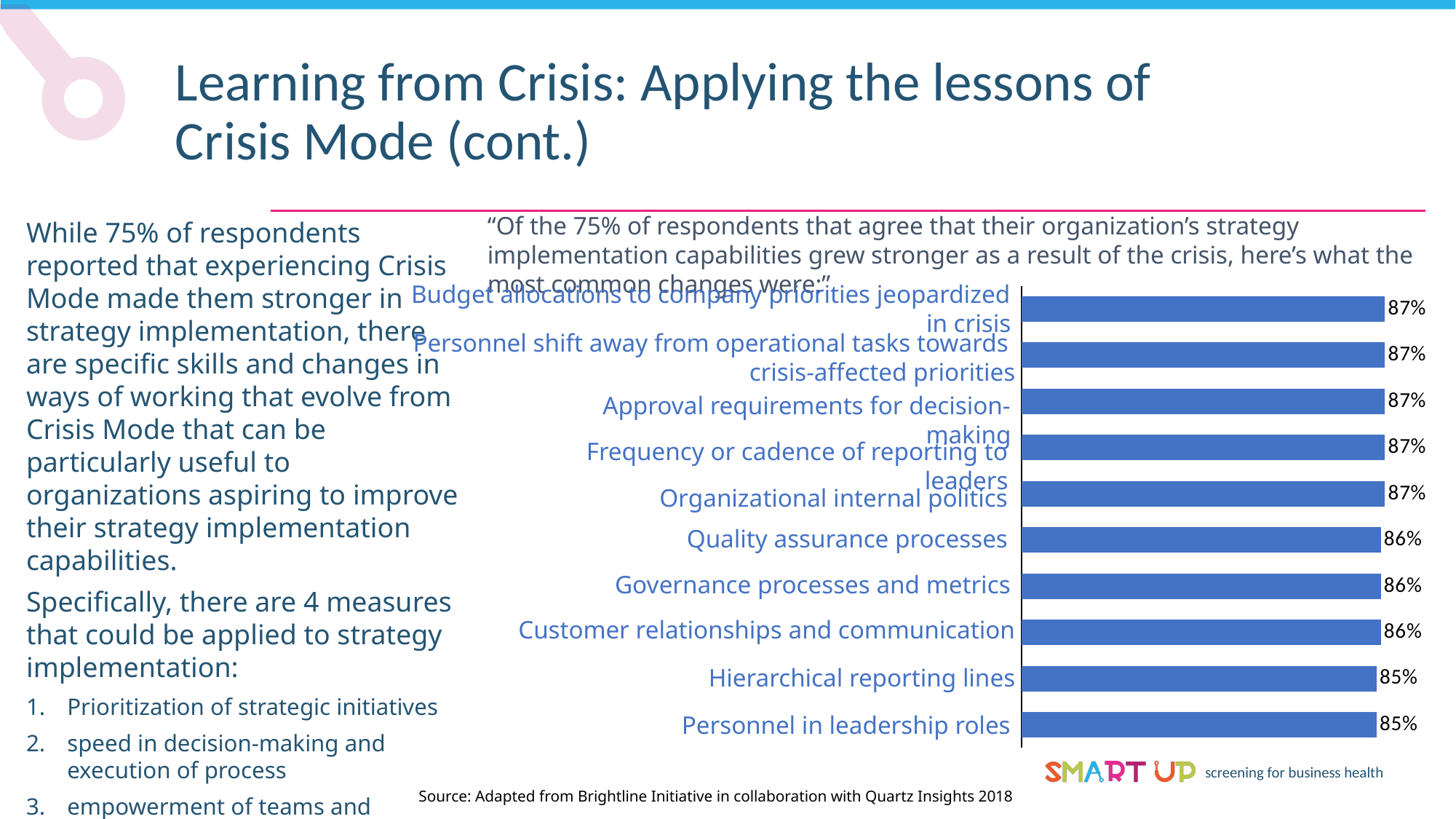
What value is shown for Customer relationships and communication? 86% Which has a larger value, Governance processes and metrics or Hierarchical reporting lines? Governance processes and metrics What is the source cited for the chart? Adapted from Brightline Initiative in collaboration with Quartz Insights 2018 What value is shown for Personnel in leadership roles? 85% What is the highest value shown on the chart? 87% How many categories are shown in the chart? 10 What is the lowest value shown on the chart? 85% What kind of chart is shown on the slide? Bar chart What is the difference between the value for Organizational internal politics and the value for Personnel in leadership roles? 2% What value is shown for Quality assurance processes? 86% What value is shown for Hierarchical reporting lines? 85% What value is shown for Organizational internal politics? 87%